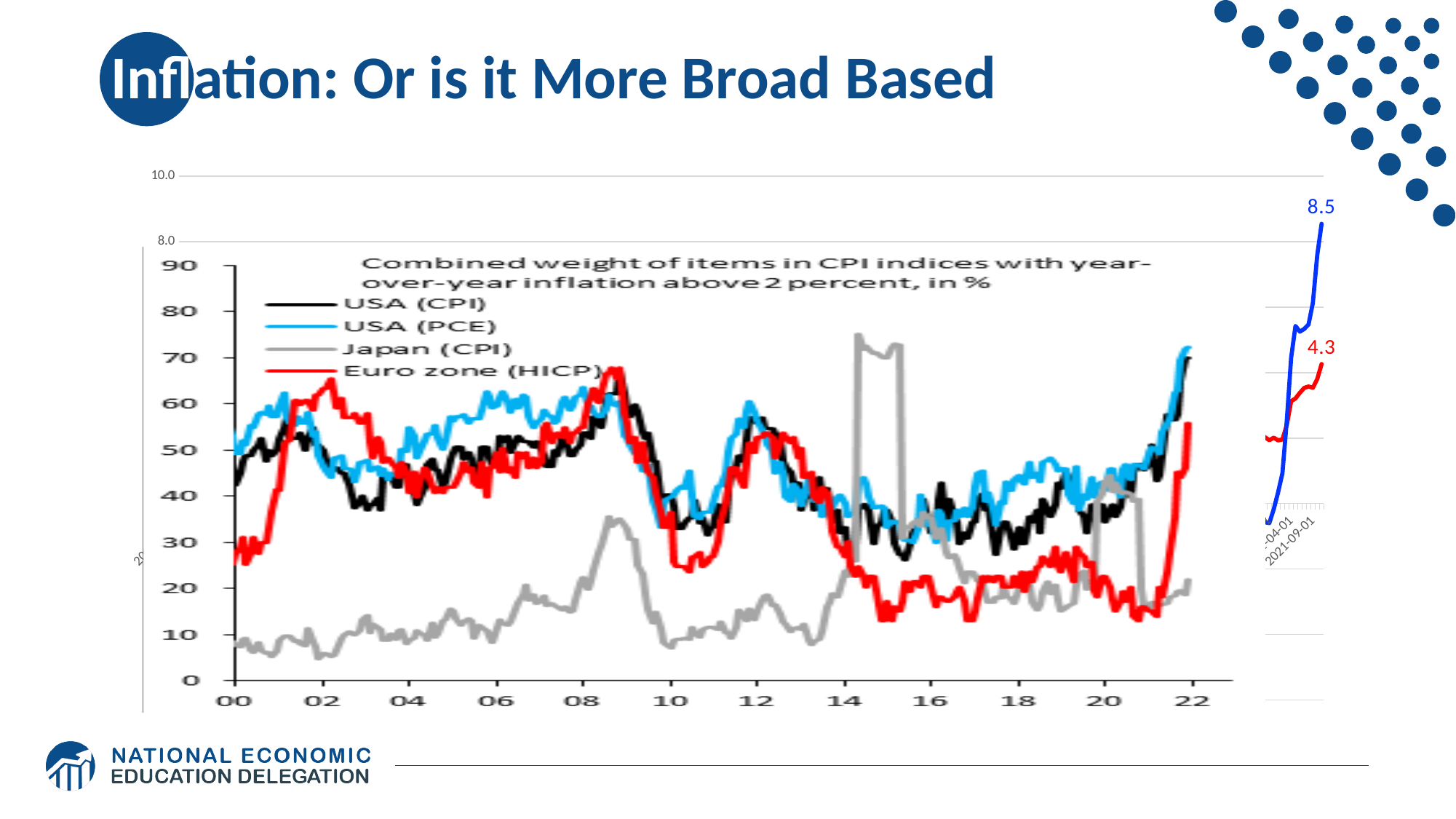
In the main chart, which is larger at the start of the series in 2000: USA (PCE) or Japan (CPI)? USA (PCE) In the main chart, is the value for USA (PCE) at the end of the series in 2022 greater or less than 60? greater How many series does the legend of the main chart list? 4 In the main chart, does the USA (CPI) series rise or fall between 2020 and 2022? rise What kind of chart is the main chart titled 'Combined weight of items in CPI indices with year-over-year inflation above 2 percent, in %'? line chart In the main chart, does the Euro zone (HICP) series rise or fall between 2008 and 2010? fall In the main chart, which series is shown in grey? Japan (CPI) In the main chart, which series is shown in red? Euro zone (HICP) In the partially hidden chart behind the main chart, what is the difference between the labelled end values of the blue line (8.5) and the red line (4.3)? 4.2 In the partially hidden chart behind the main chart, what value is labelled at the end of the blue line? 8.5 In the main chart, is the value for Japan (CPI) at its spike around 2014-15 greater or less than 60? greater In the main chart, is the value for Euro zone (HICP) around 2017 greater or less than 30? less